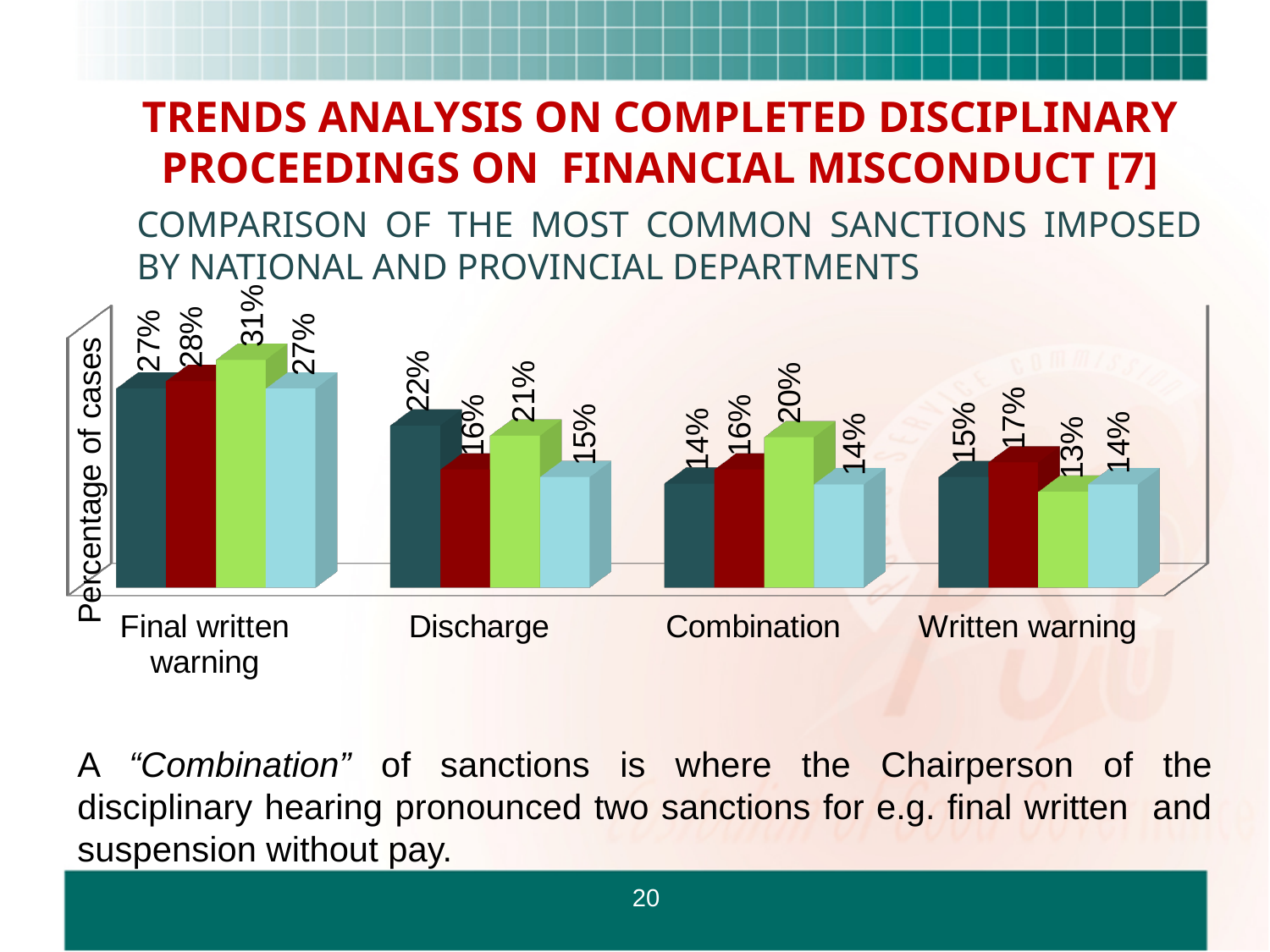
What is the label on the vertical axis of the chart? Percentage of cases How many sanction categories are shown on the x axis of the chart? 4 Which sanction category has the lowest value for the light green bar? Written warning What is the difference between the dark teal bar for Discharge and the dark teal bar for Combination? 8% What is the value of the light green bar for Final written warning? 31% Which sanction category has the highest value for the light green bar? Final written warning What is the value of the dark red (second) bar for Written warning? 17% What kind of chart is shown on the slide? bar chart What is the value of the light blue (fourth) bar for Combination? 14% Which is larger for Discharge: the dark teal bar or the dark red bar? the dark teal bar What is the difference between the light green bar and the dark red bar for Combination? 4% What is the value of the dark teal (first) bar for Discharge? 22%